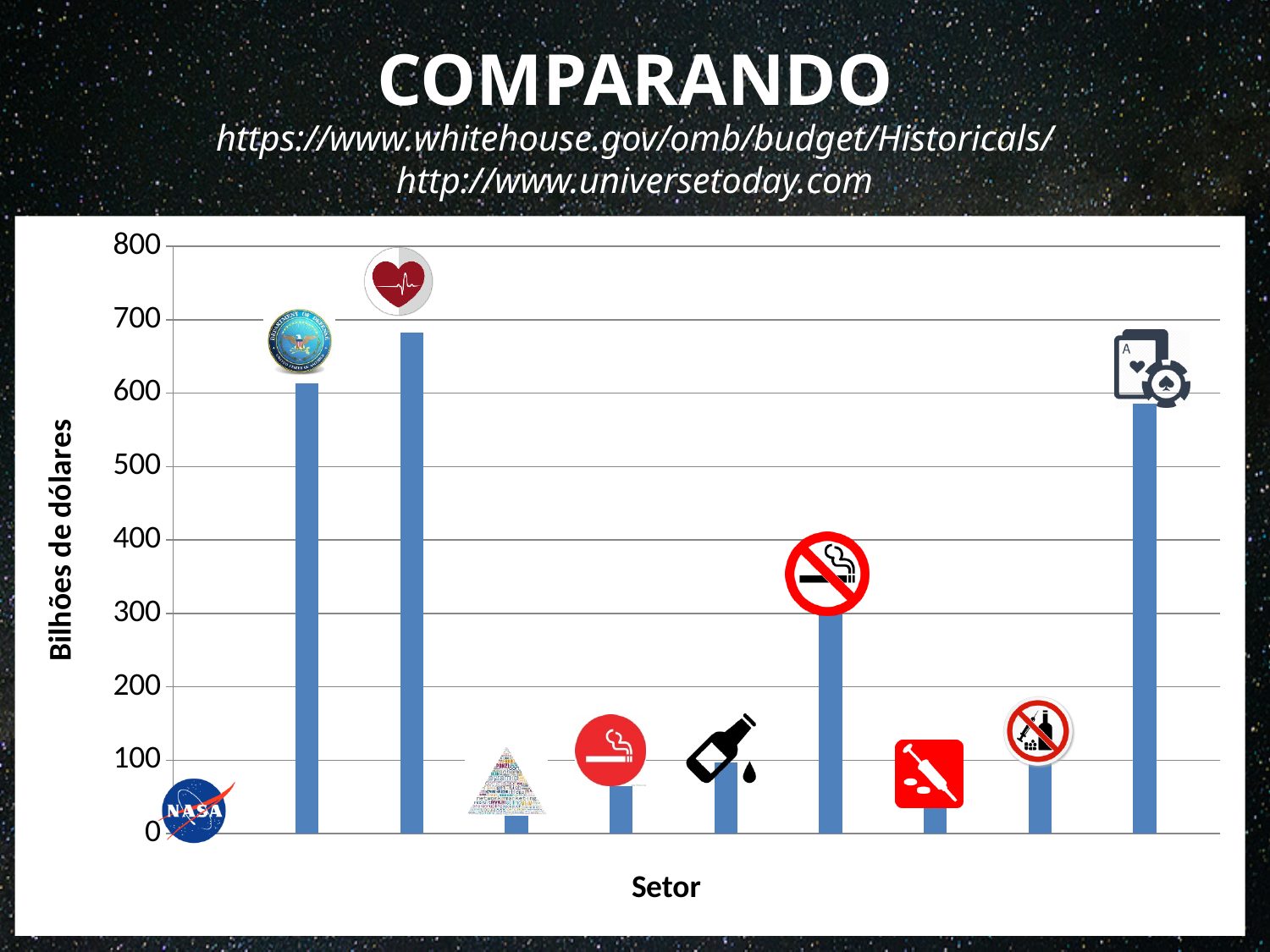
What kind of chart is shown on the slide? bar chart What is the title of the vertical axis of the chart? Bilhões de dólares Which is larger: the second bar from the left (Department of Defense seal) or the third bar from the left (heart icon)? the third bar from the left (heart icon) Is the value of the bar with the red no-smoking sign greater or less than 400? less What is the title of the horizontal axis of the chart? Setor Is the value of the second bar from the left (with the Department of Defense seal) greater or less than 600? greater Is the value of the bar with the food pyramid icon greater or less than 100? less Which is larger: the third bar from the left (heart icon) or the rightmost bar (playing-card icon)? the third bar from the left (heart icon) Which bar has the highest value in the chart? the third bar from the left (heart icon)